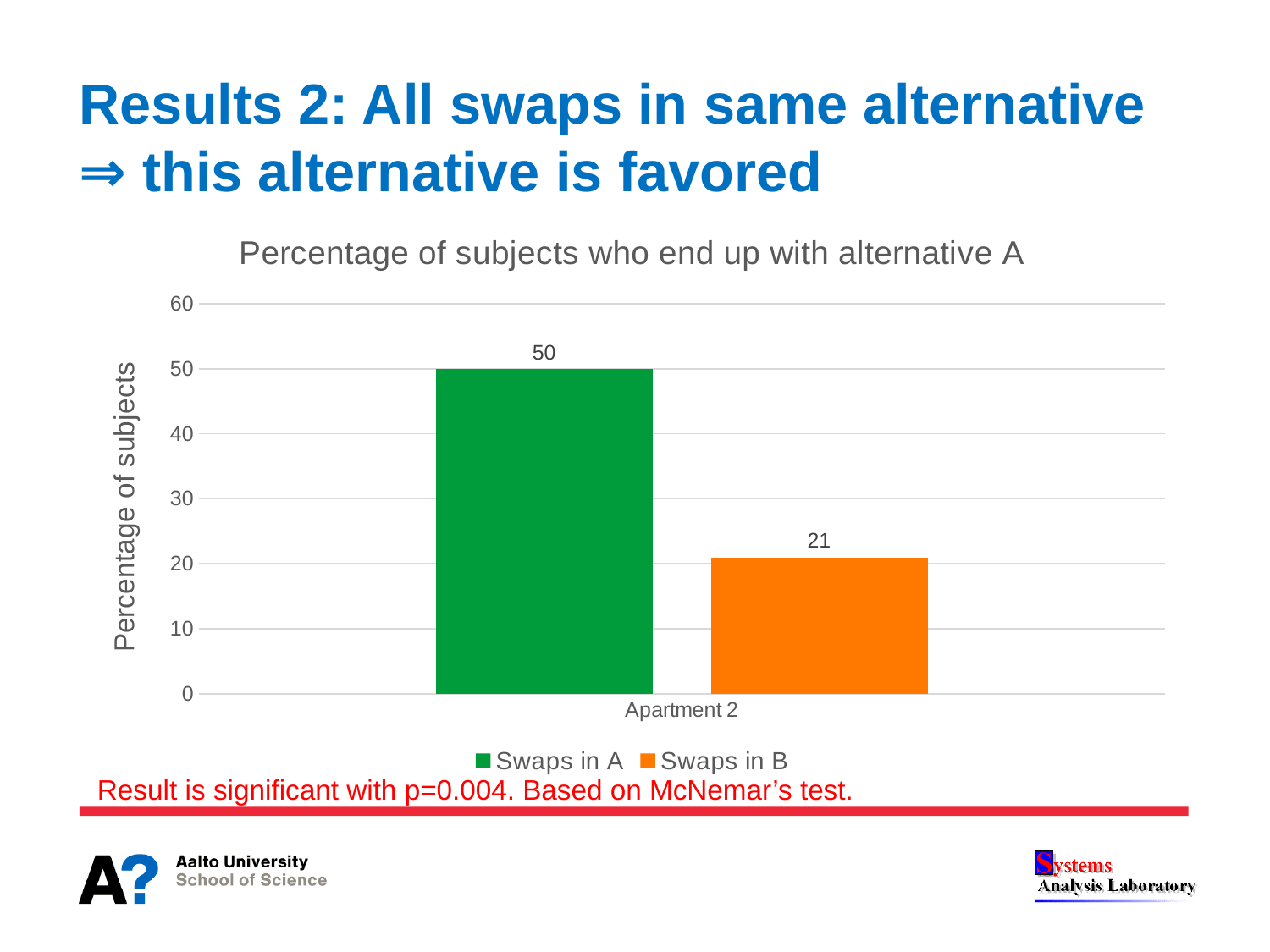
What is the value for Swaps in A for Apartment 2? 50 Is the value for Swaps in B greater or less than 30? less How many series does the legend list? 2 What is the title of the chart? Percentage of subjects who end up with alternative A Which series has the higher value for Apartment 2? Swaps in A What kind of chart is shown on the slide? bar chart Is the value for Swaps in A larger or smaller than the value for Swaps in B? larger What is the label of the y axis? Percentage of subjects Which series has the lower value for Apartment 2? Swaps in B What is the difference between the Swaps in A and Swaps in B values for Apartment 2? 29 What is the value for Swaps in B for Apartment 2? 21 How many categories are shown on the x axis? 1